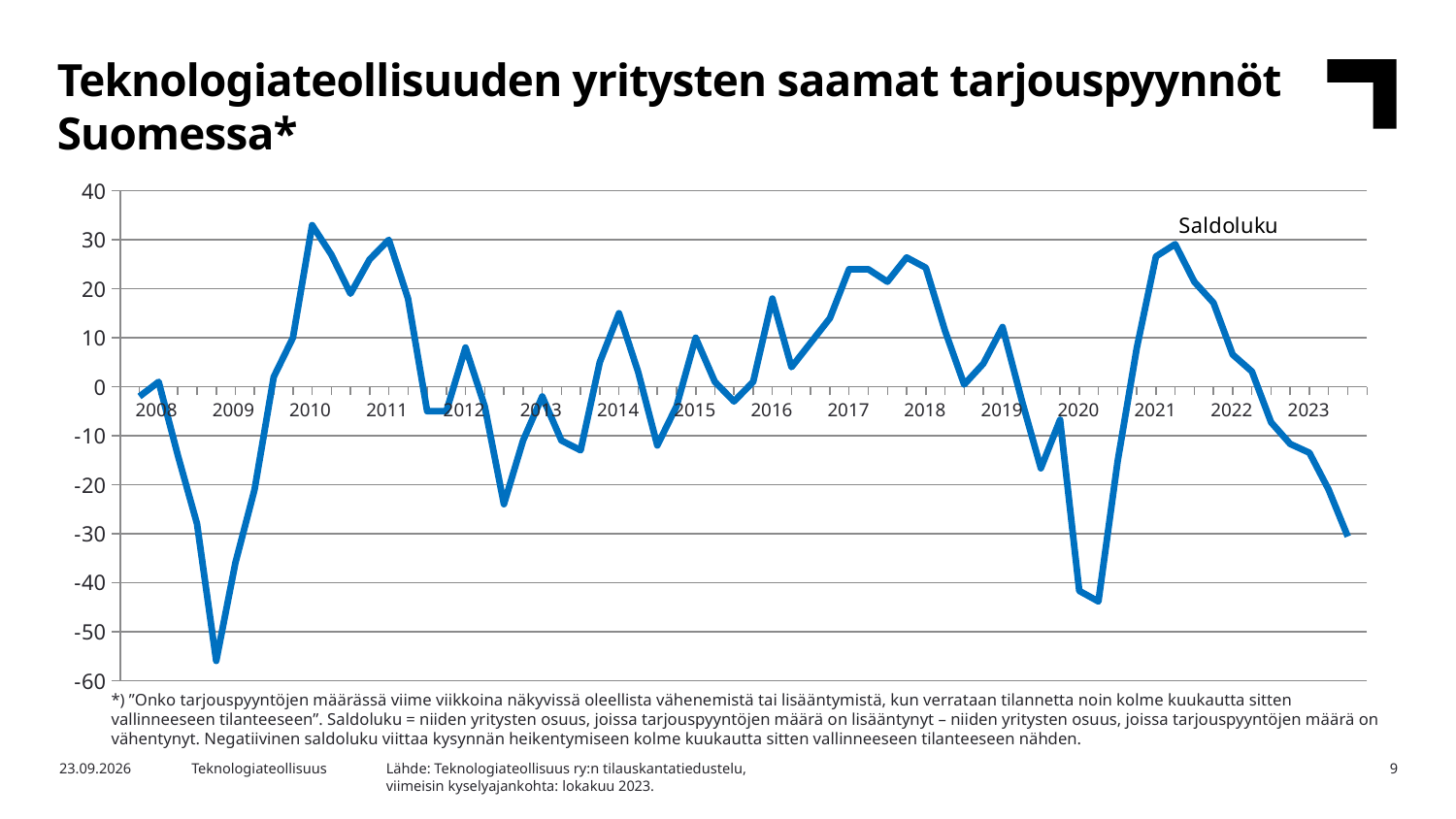
Does the Saldoluku line rise or fall from its 2021 peak to the end of 2023? fall What is the title of the chart on the slide? Saldoluku What is the name of the series plotted in the chart? Saldoluku What kind of chart is shown on the slide? line chart Is the lowest value of the Saldoluku line in 2009 greater or less than -50? less Is the highest value of the Saldoluku line in 2021 greater or less than 20? greater How many series does the chart show? 1 Is the last plotted value of the Saldoluku line in 2023 greater or less than -20? less Which is larger: the lowest value of the Saldoluku line in 2009 or the lowest value in 2020? 2020 How many years are labelled on the x axis of the chart? 16 In which year does the Saldoluku line reach its lowest point? 2009